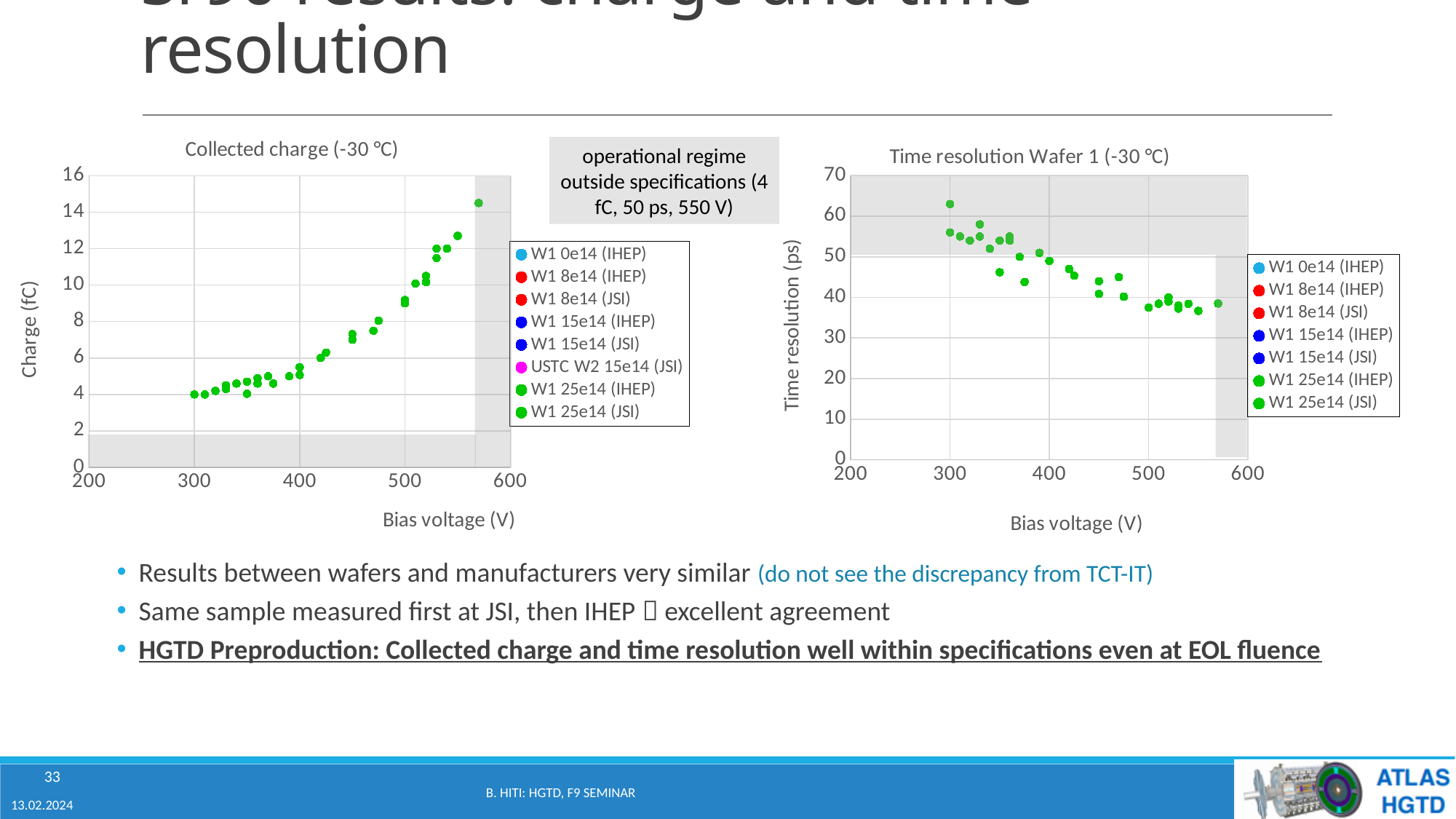
In the 'Time resolution Wafer 1 (-30 °C)' chart, do the plotted values rise or fall as bias voltage increases? fall How many series does the legend of the 'Collected charge (-30 °C)' chart list? 8 How many series does the legend of the 'Time resolution Wafer 1 (-30 °C)' chart list? 7 In the 'Time resolution Wafer 1 (-30 °C)' chart, is the time resolution at the highest plotted bias voltage (around 570 V) greater or less than 50 ps? less In the 'Collected charge (-30 °C)' chart, is the charge at the highest plotted bias voltage (around 570 V) greater or less than 12 fC? greater What is the x-axis label of the 'Time resolution Wafer 1 (-30 °C)' chart? Bias voltage (V) What type of chart is the 'Time resolution Wafer 1 (-30 °C)' chart? scatter chart What is the y-axis label of the 'Collected charge (-30 °C)' chart? Charge (fC) In the 'Collected charge (-30 °C)' chart, is the charge at 300 V greater or less than 6 fC? less What type of chart is the 'Collected charge (-30 °C)' chart? scatter chart In the 'Collected charge (-30 °C)' chart, do the plotted values rise or fall as bias voltage increases? rise